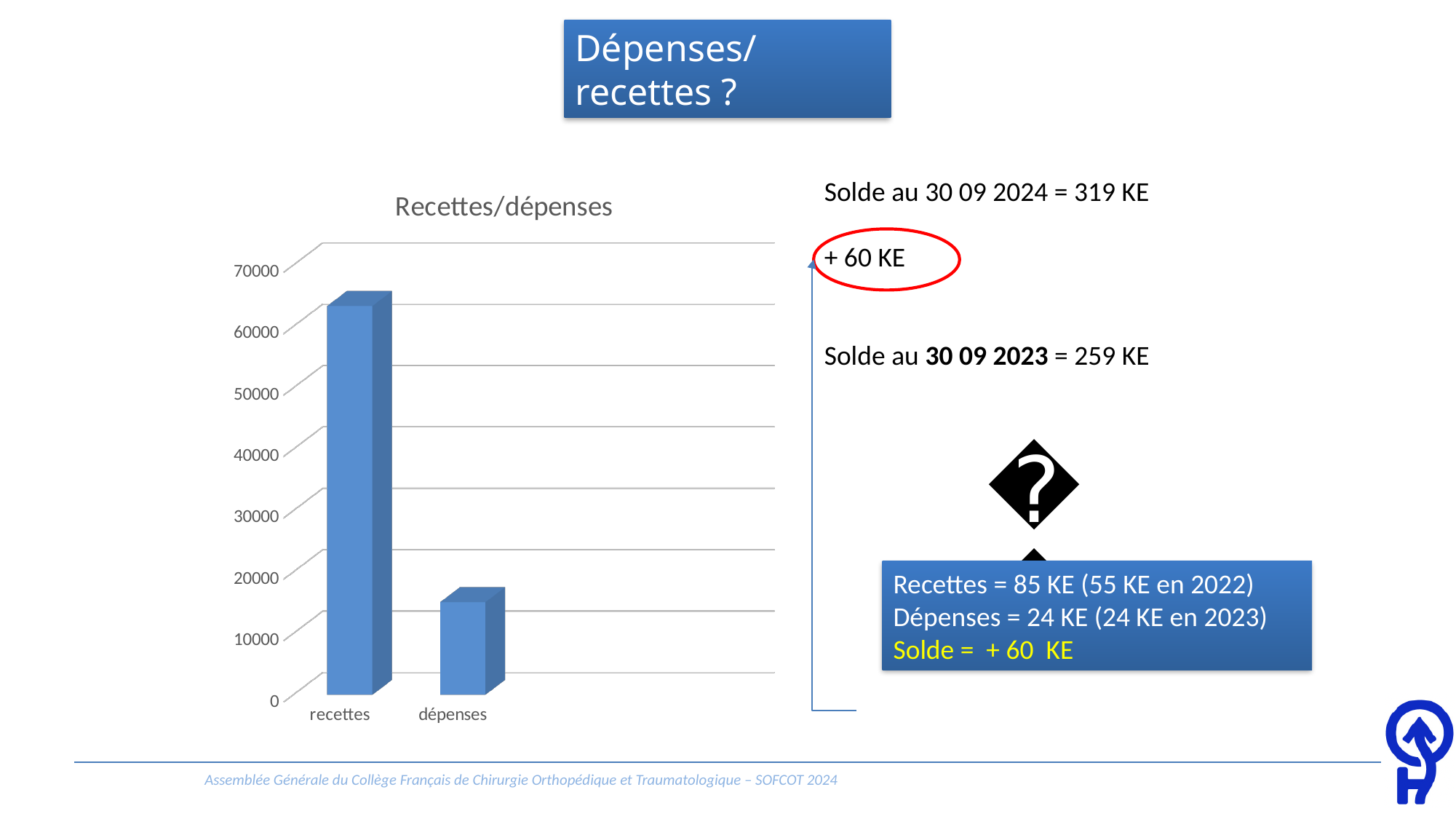
Is the value for recettes greater or less than 70000? less Which category has the lowest value in the chart? dépenses Which is larger in the chart, recettes or dépenses? recettes Is the value for dépenses greater or less than 10000? greater Is the value for dépenses greater or less than 20000? less Which category has the highest value in the chart? recettes How many categories are plotted in the chart? 2 What is the highest tick value shown on the vertical axis of the chart? 70000 What kind of chart is shown on the slide? bar chart What is the title of the chart? Recettes/dépenses